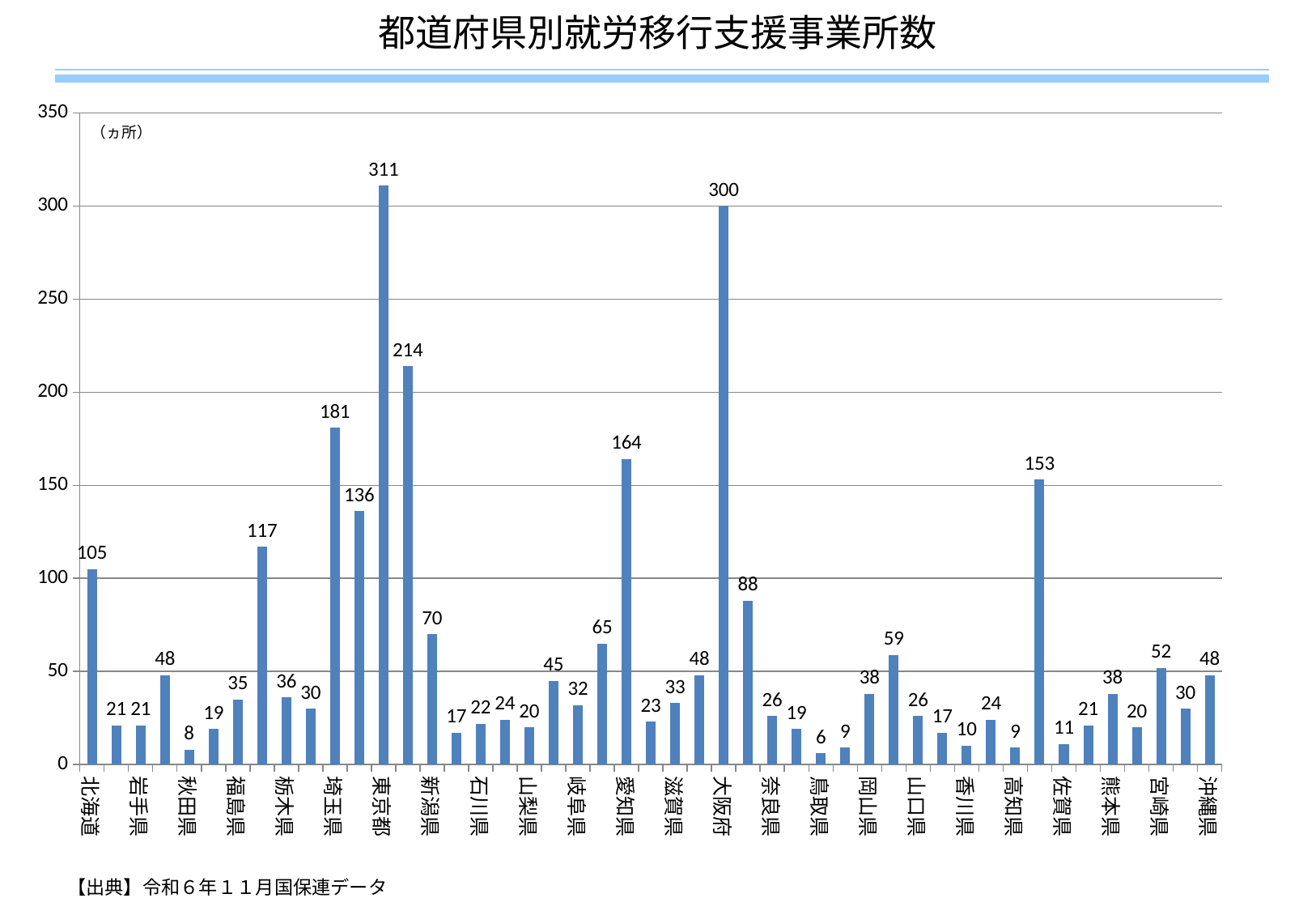
What is the title of the chart? 都道府県別就労移行支援事業所数 Is the value for 新潟県 greater or less than 50? greater What is the value for 愛知県? 164 Which is larger, the value for 埼玉県 or the value for 愛知県? 埼玉県 What is the value for 大阪府? 300 Which labeled prefecture has the lowest value on the chart? 鳥取県 What unit is indicated in the top-left corner of the plot area? （ヵ所） What is the value for 北海道? 105 What is the difference between the values for 東京都 and 大阪府? 11 What type of chart is shown on the slide? bar chart What is the value for 東京都? 311 Which prefecture has the highest number of 就労移行支援事業所? 東京都